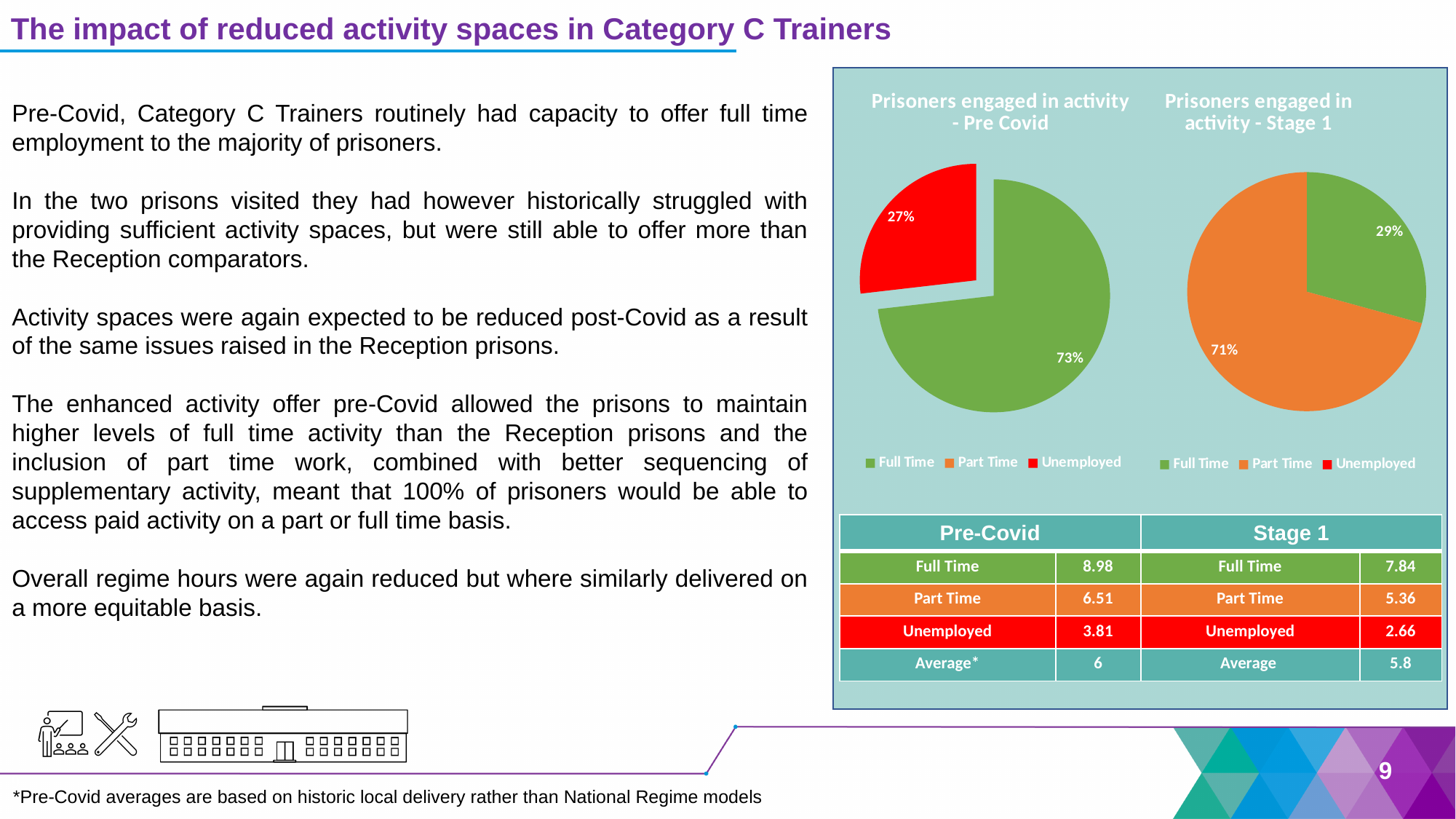
In the 'Prisoners engaged in activity - Pre Covid' chart, which category has the largest slice? Full Time In the 'Prisoners engaged in activity - Stage 1' chart, which category has the largest slice? Part Time In the 'Prisoners engaged in activity - Pre Covid' chart, what share of prisoners is Unemployed? 27% In the 'Prisoners engaged in activity - Pre Covid' chart, what share of prisoners is Full Time? 73% In the 'Prisoners engaged in activity - Pre Covid' chart, what is the difference in percentage points between the Full Time and Unemployed slices? 46 In the 'Prisoners engaged in activity - Stage 1' chart, what is the difference in percentage points between the Part Time and Full Time slices? 42 In the 'Prisoners engaged in activity - Stage 1' chart, what share of prisoners is Full Time? 29% What type of chart is used for 'Prisoners engaged in activity - Pre Covid'? Pie chart In the 'Prisoners engaged in activity - Stage 1' chart, what share of prisoners is Part Time? 71% How many entries does the legend of the 'Prisoners engaged in activity - Stage 1' chart list? 3 In the 'Prisoners engaged in activity - Stage 1' chart, what colour is the Part Time slice? Orange Which is larger: the Full Time share in the Pre Covid chart or the Full Time share in the Stage 1 chart? Pre Covid